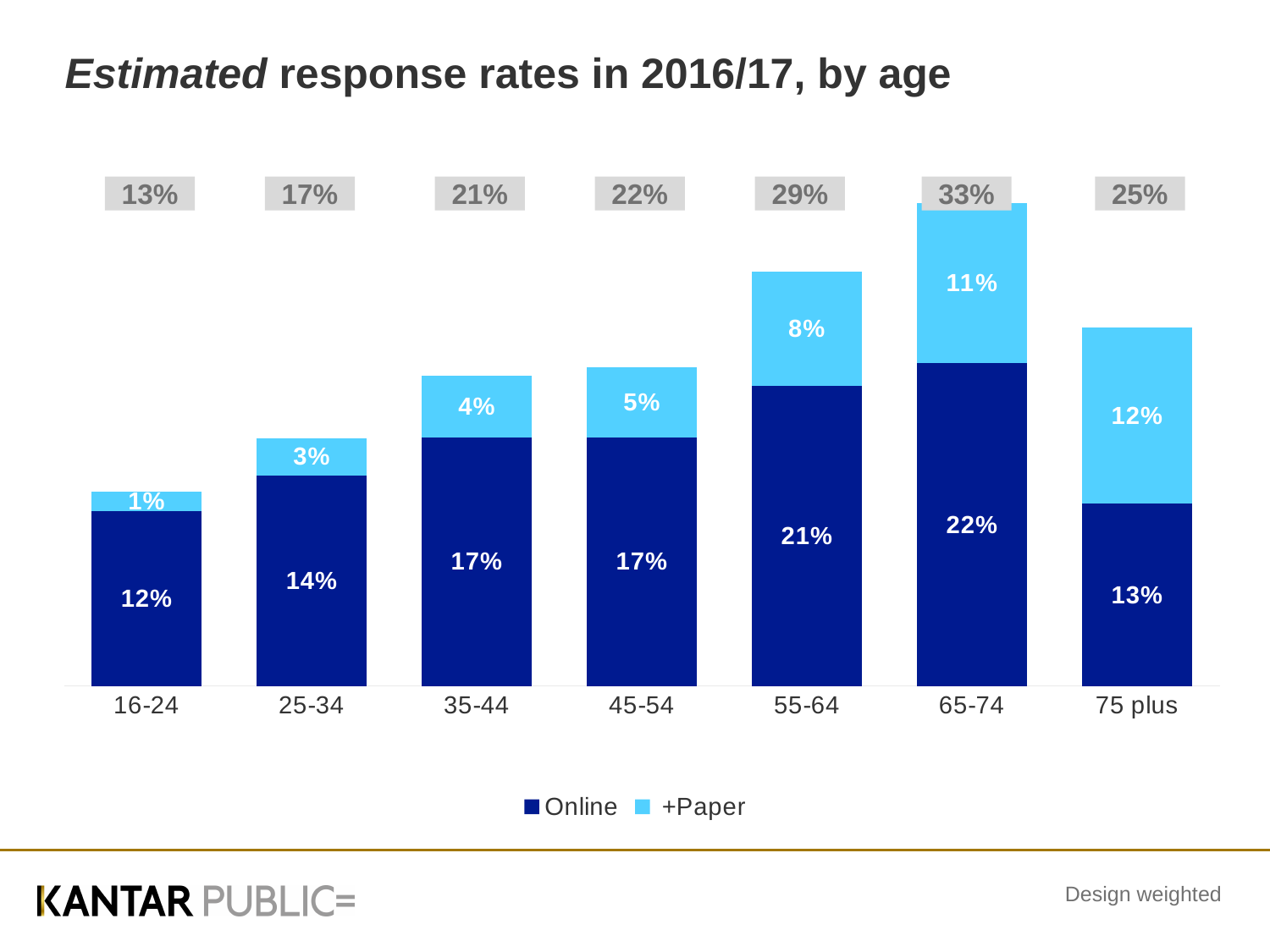
What is the +Paper value for the 75 plus age group? 12% Which age group has the lowest Online response rate? 16-24 What is the difference between the Online response rates for 65-74 and 16-24? 10% What is the total of the stacked bar for the 45-54 age group? 22% Which is larger, the +Paper value for 55-64 or the +Paper value for 75 plus? 75 plus What is the Online response rate for the 55-64 age group? 21% How many series does the legend list? 2 What kind of chart is shown on the slide? Stacked bar chart What is the total estimated response rate shown above the bar for the 65-74 age group? 33% How many age groups are shown on the x axis? 7 What are the two series named in the legend? Online and +Paper Which age group has the highest total estimated response rate? 65-74